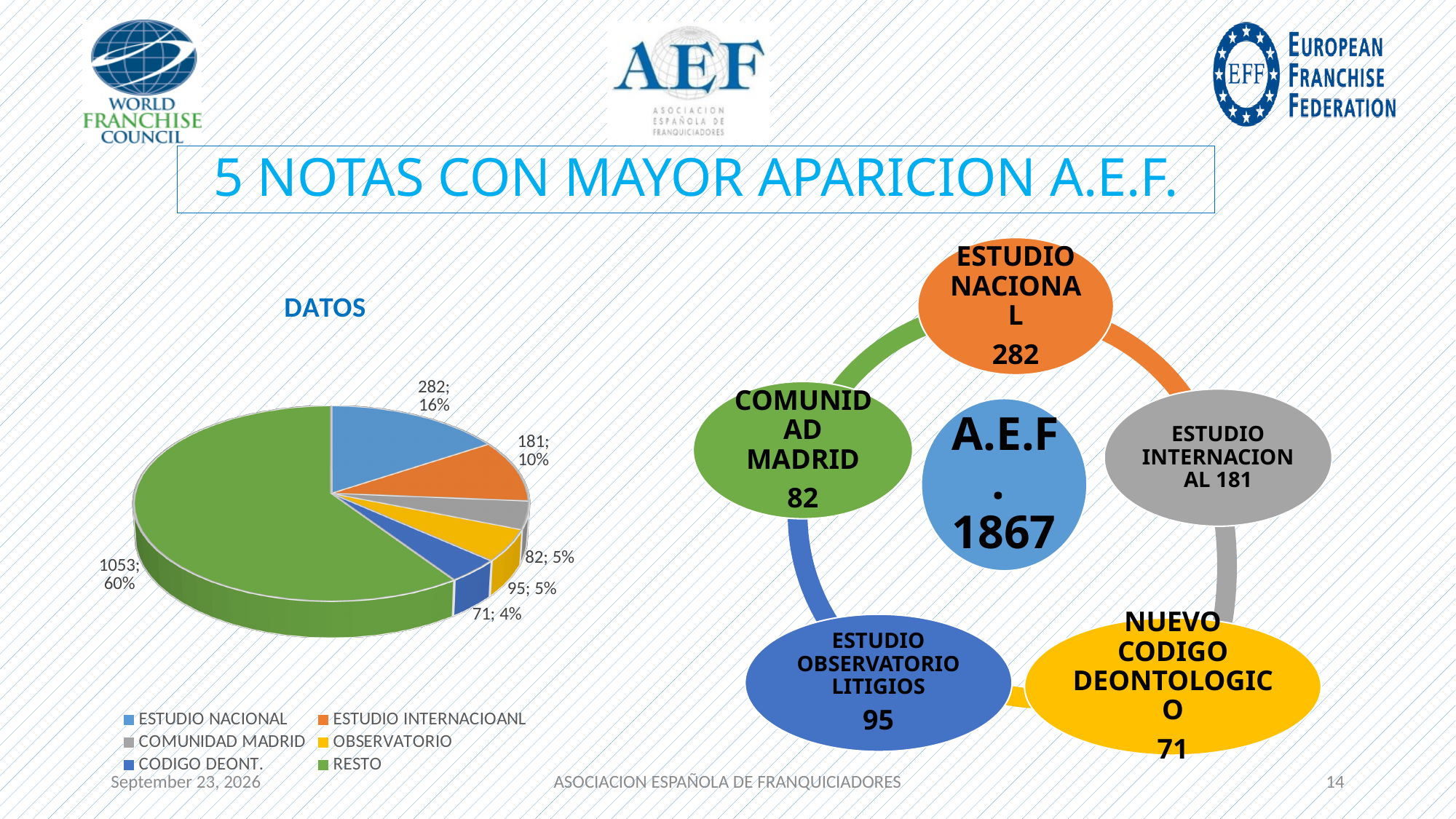
In the DATOS pie chart, what value is shown for ESTUDIO INTERNACIOANL? 181 How many entries does the legend of the DATOS chart list? 6 In the DATOS pie chart, what value is shown for ESTUDIO NACIONAL? 282 In the DATOS pie chart, what share of the total does RESTO represent? 60% In the DATOS pie chart, which category has the smallest slice? CODIGO DEONT. In the DATOS pie chart, what value is shown for OBSERVATORIO? 95 How many slices does the DATOS pie chart have? 6 In the DATOS pie chart, which category has the largest slice? RESTO In the DATOS pie chart, what value is shown for CODIGO DEONT.? 71 What kind of chart is the DATOS chart? Pie chart In the DATOS pie chart, what is the difference between the values for ESTUDIO NACIONAL and ESTUDIO INTERNACIOANL? 101 In the DATOS pie chart, which is larger: OBSERVATORIO or COMUNIDAD MADRID? OBSERVATORIO